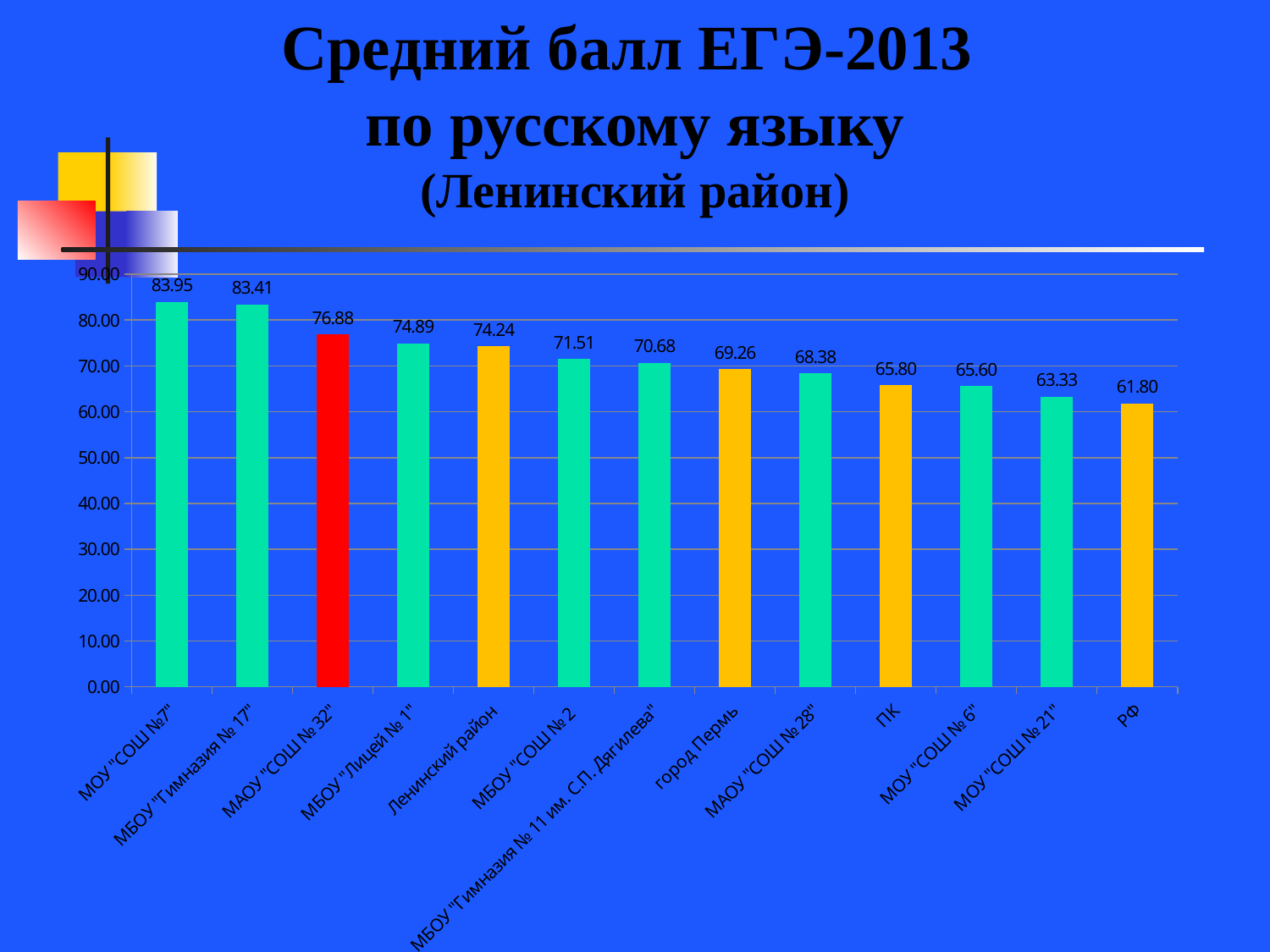
What kind of chart is shown on the slide? bar chart What is the value for РФ? 61.80 Which category has the highest value? МОУ "СОШ №7" What is the value for Ленинский район? 74.24 What is the value for МАОУ "СОШ № 32"? 76.88 What is the title of the chart on the slide? Средний балл ЕГЭ-2013 по русскому языку (Ленинский район) Do the values rise or fall from left to right along the x axis? fall Which category has the lowest value? РФ What is the difference between the values for МОУ "СОШ №7" and РФ? 22.15 What is the value for город Пермь? 69.26 How many categories are shown on the x axis? 13 Which is larger, the value for МБОУ "Лицей № 1" or the value for МБОУ "СОШ № 2"? МБОУ "Лицей № 1"